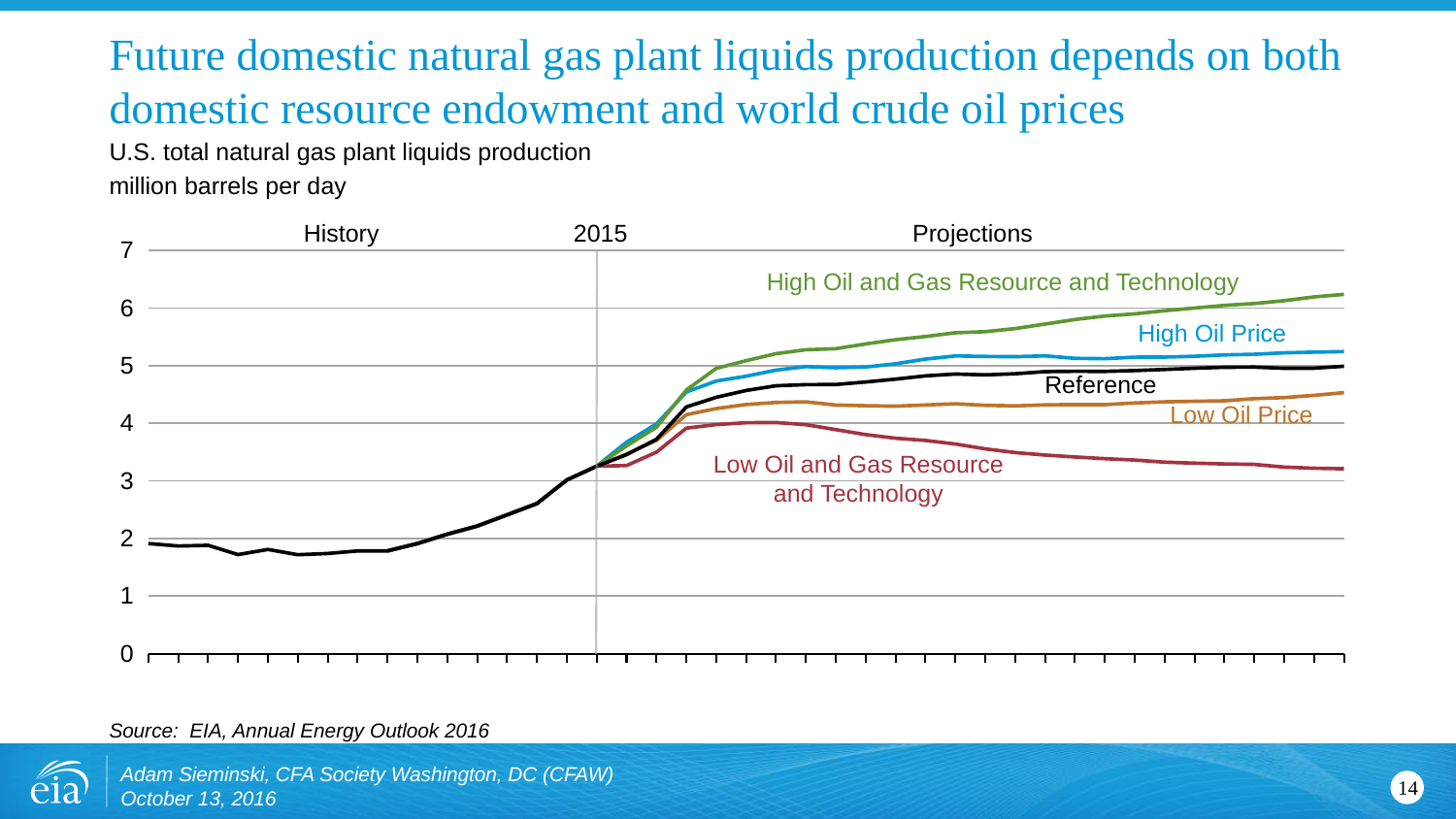
What kind of chart is shown on the slide? line chart Which projection scenario has the lowest natural gas plant liquids production at the end of the projection period? Low Oil and Gas Resource and Technology Is the value for the High Oil and Gas Resource and Technology scenario at the end of the projection period greater or less than 6? greater Which projection scenario has the highest natural gas plant liquids production at the end of the projection period? High Oil and Gas Resource and Technology Is the value for the High Oil Price scenario at the end of the projection period greater or less than 5? greater Is the value for the Low Oil Price scenario at the end of the projection period greater or less than 5? less At the end of the projection period, which is higher: the High Oil Price scenario or the Reference scenario? High Oil Price Does production in the History portion of the chart generally rise or fall toward 2015? rise Does the Low Oil and Gas Resource and Technology line rise or fall over the later part of the projection period? fall How many projection scenario lines are labeled on the chart? 5 What unit is the y axis of the chart measured in? million barrels per day